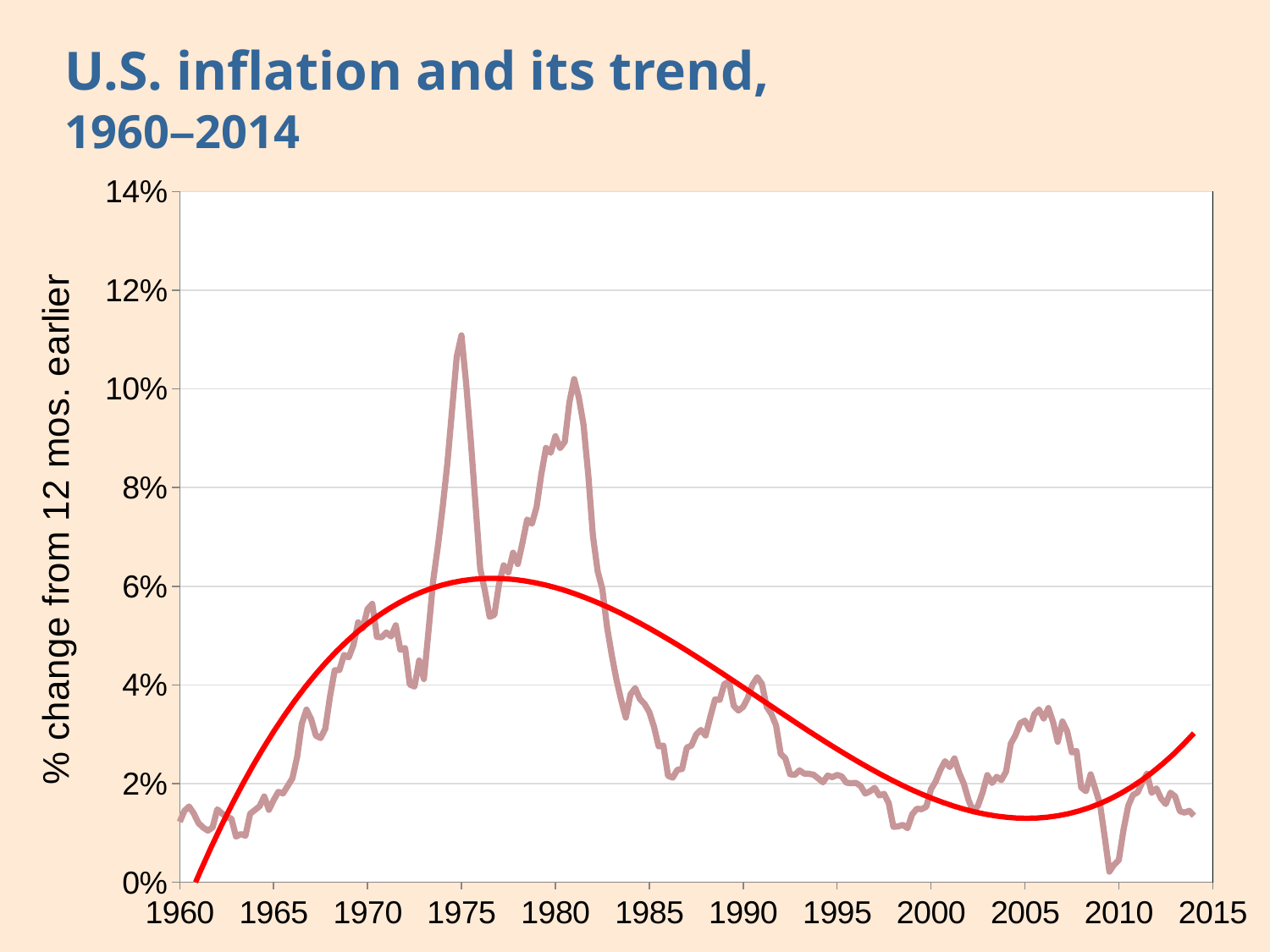
Is the peak value of the inflation line around 1975 greater or less than 10%? greater Is the lowest point of the inflation line around 2009 greater or less than 2%? less In roughly which year does the inflation line reach its highest peak? 1975 Does the inflation line rise or fall between 1981 and 1985? fall Does the inflation line rise or fall between 1965 and 1970? rise What kind of chart is shown on the slide? line chart Is the inflation value in 1960 greater or less than 2%? less Which peak of the inflation line is higher, the one around 1975 or the one around 1980? 1975 What is the title of the chart? U.S. inflation and its trend, 1960–2014 What is the label on the vertical axis? % change from 12 mos. earlier